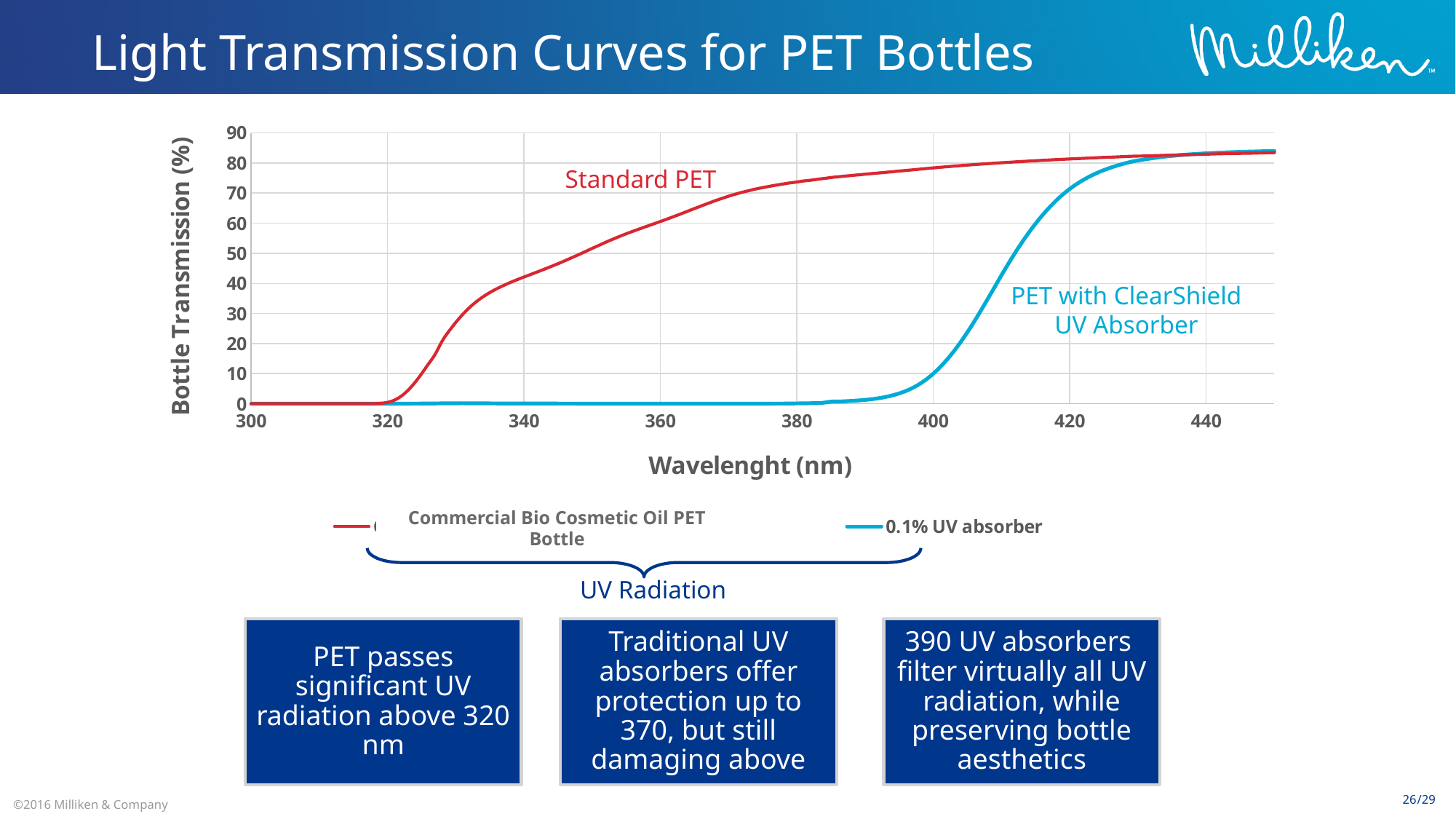
What is the label of the y axis? Bottle Transmission (%) Is the transmission of PET with ClearShield UV Absorber at 380 nm greater or less than 10? less At 360 nm, which curve shows higher transmission: Standard PET or PET with ClearShield UV Absorber? Standard PET Is the transmission of PET with ClearShield UV Absorber at 440 nm greater or less than 80? greater What is the title of the chart on the slide? Light Transmission Curves for PET Bottles Is the transmission of PET with ClearShield UV Absorber at 400 nm greater or less than 20? less Does the Standard PET transmission rise or fall as wavelength increases from 320 nm to 440 nm? Rise How many series does the legend list? 2 What kind of chart is shown on the slide? Line chart At 400 nm, which curve shows higher transmission: Standard PET or PET with ClearShield UV Absorber? Standard PET